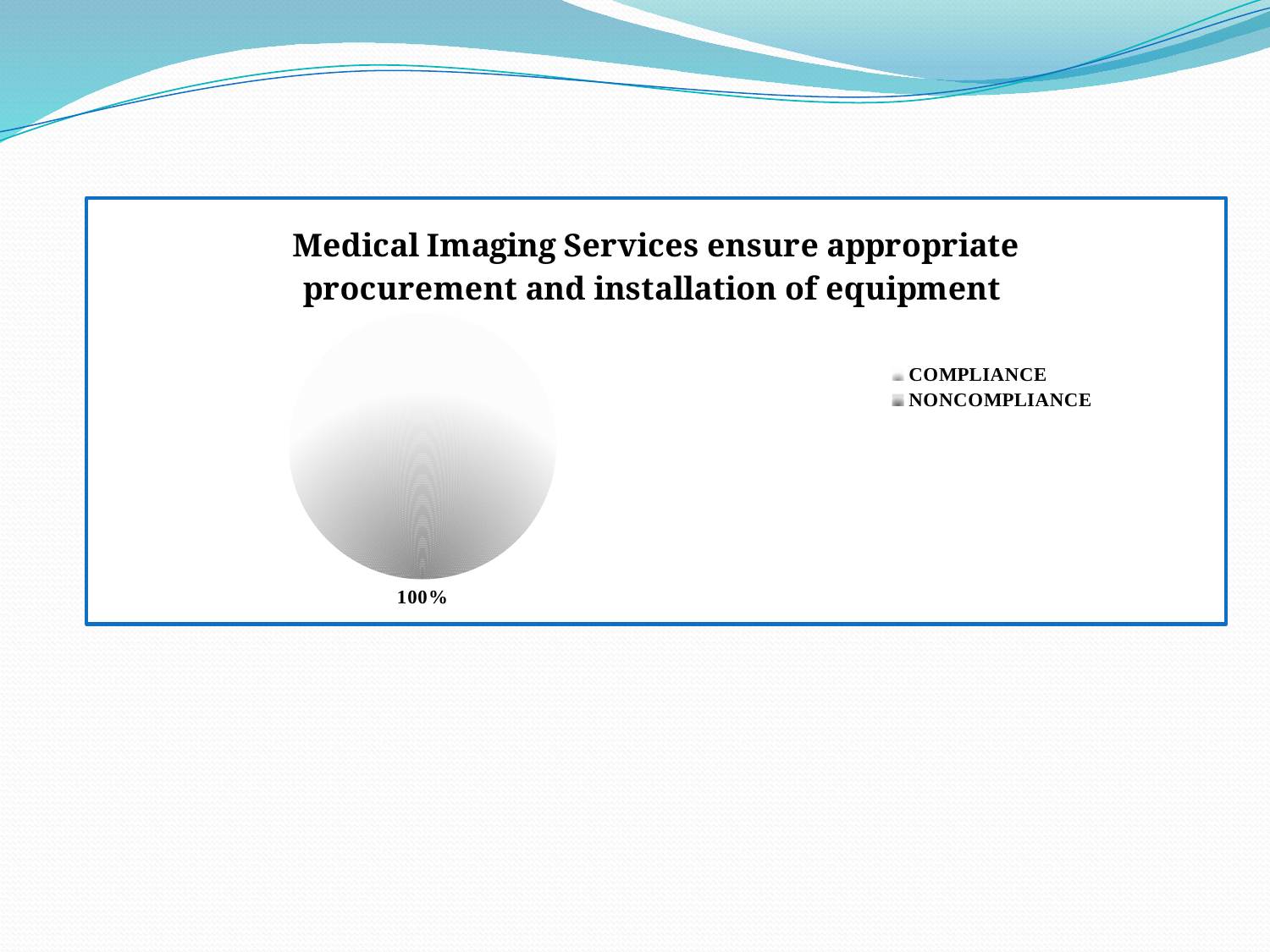
How many entries does the chart legend list? 2 Is the value shown on the pie chart's data label greater or less than 50%? greater What are the two entries listed in the chart legend? COMPLIANCE and NONCOMPLIANCE What kind of chart is shown on the slide? pie chart How many data labels are printed on the pie chart? 1 What is the title of the chart? Medical Imaging Services ensure appropriate procurement and installation of equipment What share of the pie does the single visible slice take up? 100% What percentage value is printed as the data label on the pie chart? 100%